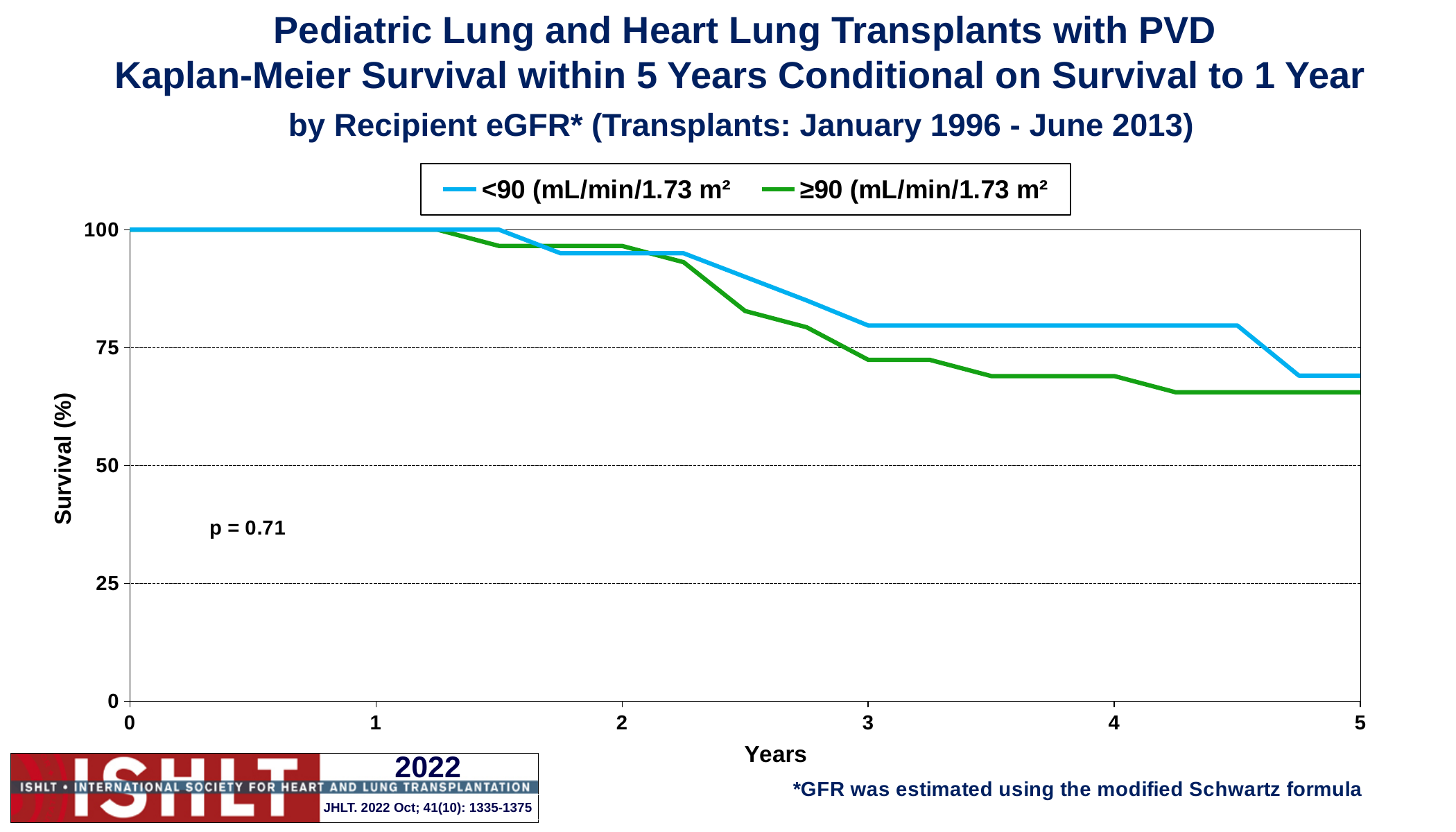
How many series does the legend list? 2 Is the survival value for the <90 (mL/min/1.73 m² group at year 4 greater or less than 75? greater Do the survival curves rise or fall as years increase? fall At year 5, which group has the higher survival: <90 (mL/min/1.73 m² or ≥90 (mL/min/1.73 m²? <90 (mL/min/1.73 m² What p-value is printed on the chart? p = 0.71 Is the survival value for the <90 (mL/min/1.73 m² group at year 5 greater or less than 75? less What kind of chart is shown on the slide? line chart What is the survival value for the <90 (mL/min/1.73 m² group at year 0? 100 Is the survival value for the ≥90 (mL/min/1.73 m² group at year 5 greater or less than 75? less Which colour is used for the ≥90 (mL/min/1.73 m² series? green What is the survival value for the ≥90 (mL/min/1.73 m² group at year 0? 100